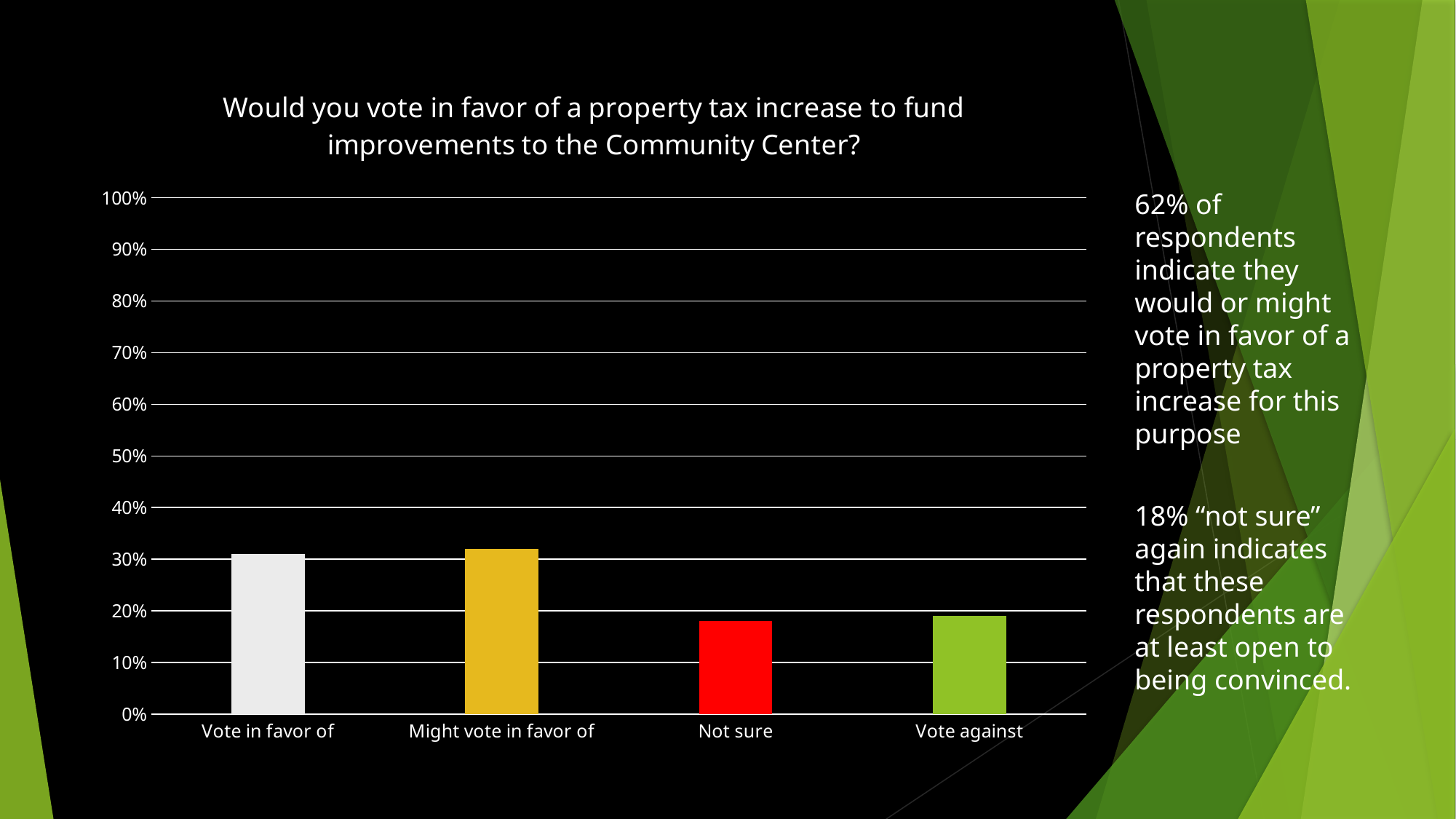
How many response categories are shown on the x axis of the chart? 4 Is the value for "Vote in favor of" greater or less than 40%? less Is the value for "Not sure" greater or less than 20%? less Which is larger, the value for "Vote in favor of" or the value for "Not sure"? Vote in favor of Is the value for "Vote against" greater or less than 30%? less Which is larger, the value for "Might vote in favor of" or the value for "Vote against"? Might vote in favor of What kind of chart is shown on the slide? bar chart Which is larger, the value for "Vote against" or the value for "Vote in favor of"? Vote in favor of What colour is the bar for "Not sure"? red What is the title of the chart? Would you vote in favor of a property tax increase to fund improvements to the Community Center?